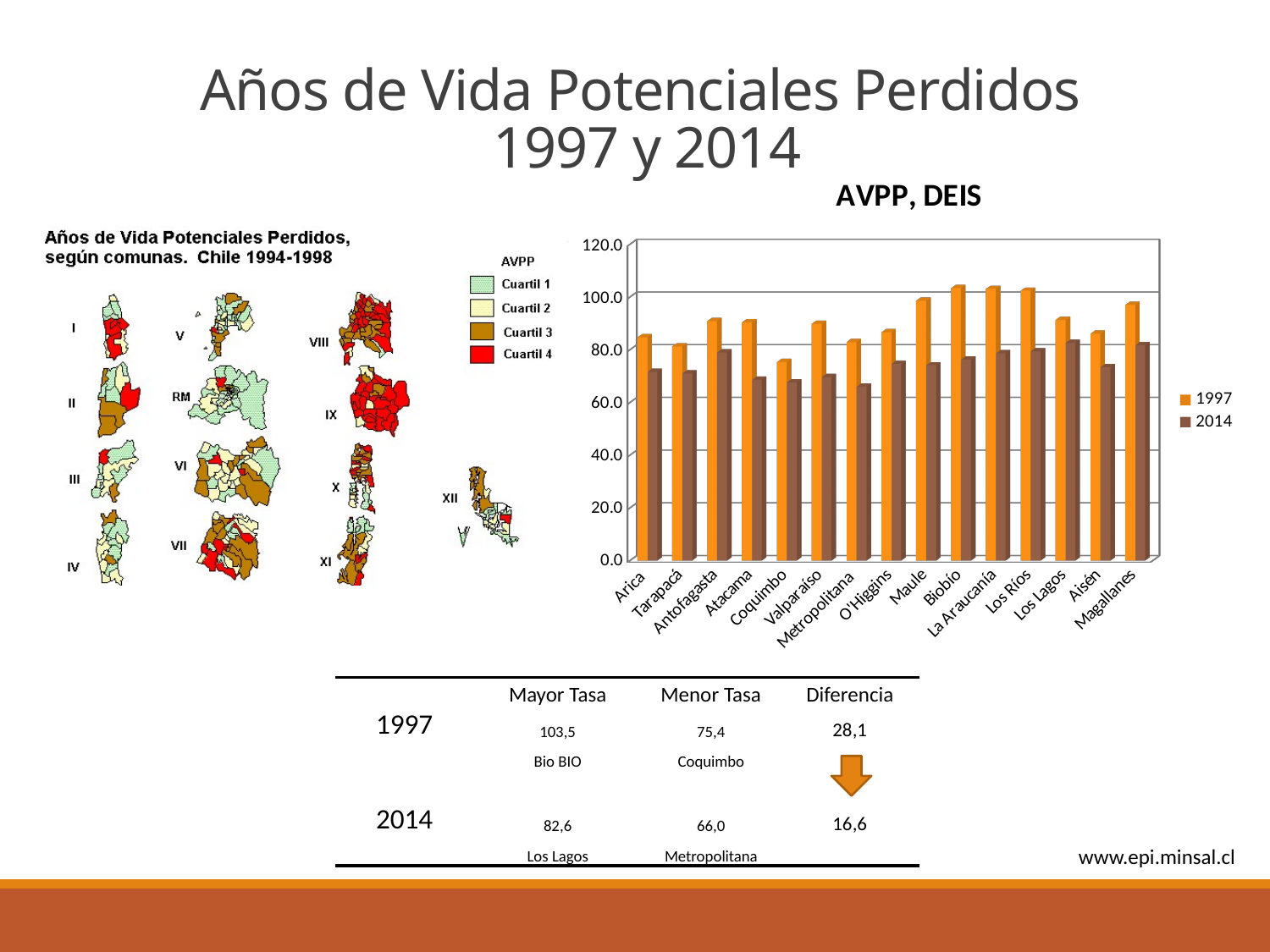
What kind of chart is the AVPP, DEIS chart? bar chart In the AVPP, DEIS chart, is the 1997 value for Biobío greater or less than 100? greater In the AVPP, DEIS chart, which region has the lowest 2014 value? Metropolitana In the AVPP, DEIS chart, which region has the highest 1997 value? Biobío In the AVPP, DEIS chart, is the 2014 value for Aisén greater or less than 80? less In the AVPP, DEIS chart, is the 1997 value for Coquimbo greater or less than 80? less In the AVPP, DEIS chart, which is larger for Los Ríos: the 1997 value or the 2014 value? 1997 How many regions are shown on the x axis of the AVPP, DEIS chart? 15 Which series in the AVPP, DEIS chart is shown in orange? 1997 How many series does the legend of the AVPP, DEIS chart list? 2 In the AVPP, DEIS chart, which region has the lowest 1997 value? Coquimbo